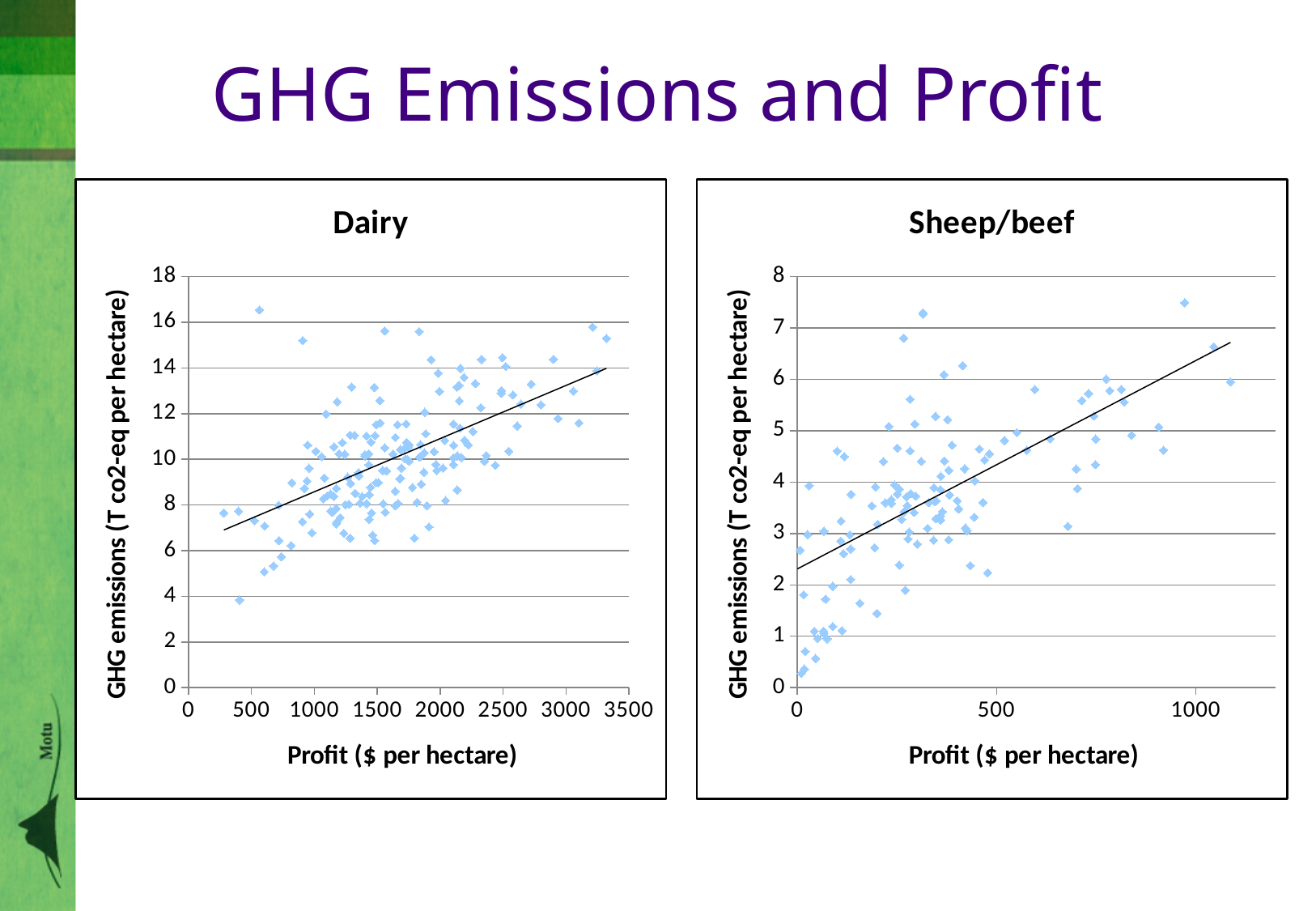
In the Dairy chart, what is the highest value shown on the vertical axis? 18 In the Dairy chart, do GHG emissions tend to rise or fall as profit per hectare increases? rise In the Dairy chart, is the highest plotted GHG emissions value greater or less than 16? greater In the Sheep/beef chart, does the fitted trend line rise or fall as profit per hectare increases? rise In the Dairy chart, what is the highest value shown on the horizontal axis? 3500 In the Sheep/beef chart, what is the highest value shown on the vertical axis? 8 What is the title of the left chart? Dairy What kind of chart is the Sheep/beef chart? scatter chart What is the title of the right chart? Sheep/beef In the Sheep/beef chart, is the highest plotted GHG emissions value greater or less than 7? greater What kind of chart is the Dairy chart? scatter chart How many charts are shown on the slide? 2